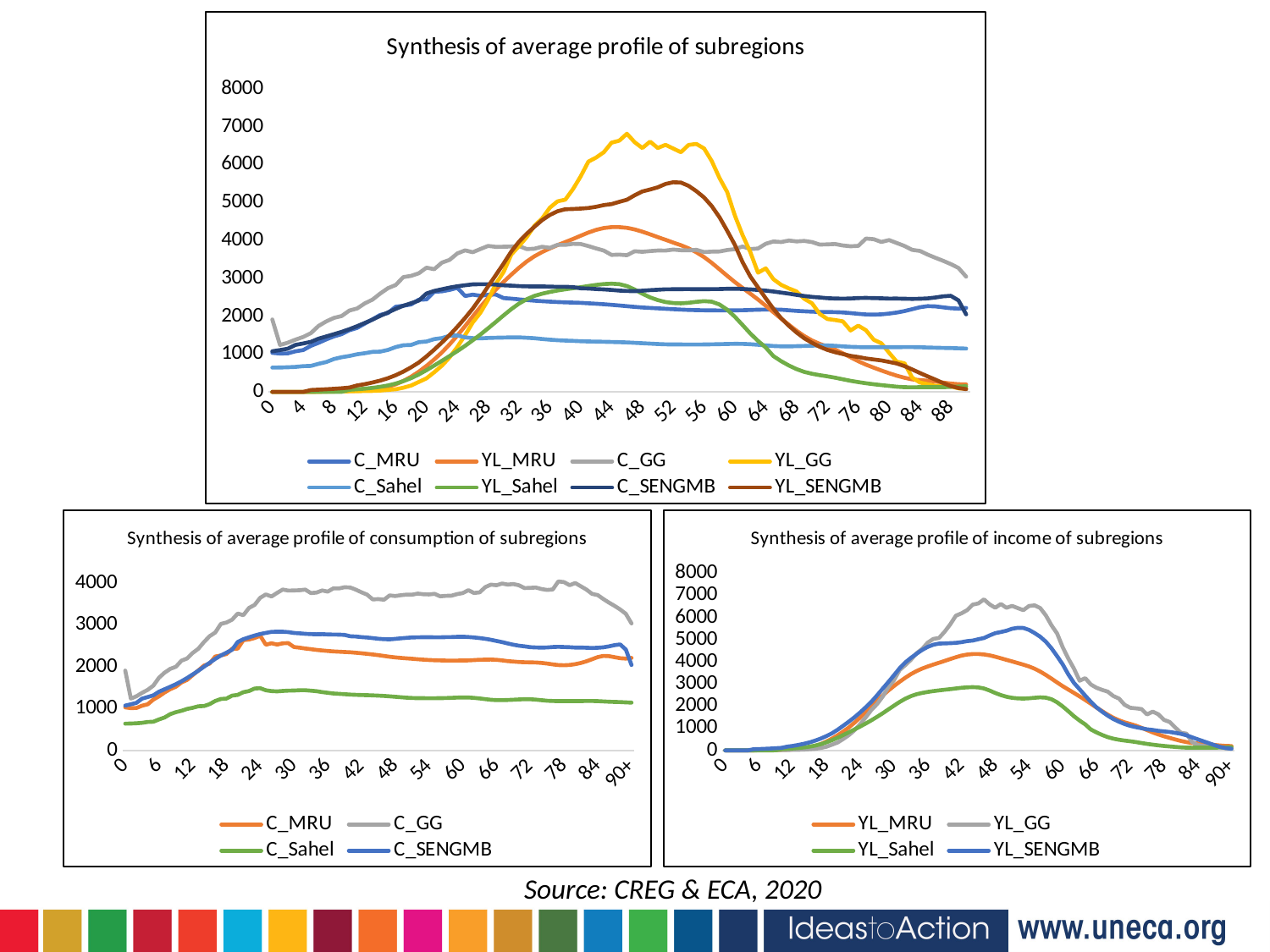
In the bottom-left chart "Synthesis of average profile of consumption of subregions", which series has the lowest values across the age range? C_Sahel In the bottom-right chart "Synthesis of average profile of income of subregions", is the value for YL_SENGMB at age 54 greater or less than 5000? greater In the top chart "Synthesis of average profile of subregions", is the value for C_Sahel at age 40 greater or less than 2000? less In the top chart "Synthesis of average profile of subregions", which series reaches the highest peak value? YL_GG In the bottom-left chart "Synthesis of average profile of consumption of subregions", how many series does the legend list? 4 In the top chart "Synthesis of average profile of subregions", how many series does the legend list? 8 In the bottom-right chart "Synthesis of average profile of income of subregions", do the values for YL_GG rise or fall between age 60 and age 84? fall In the bottom-right chart "Synthesis of average profile of income of subregions", which series reaches the highest peak? YL_GG In the top chart "Synthesis of average profile of subregions", is the value for YL_GG at age 48 greater or less than 6000? greater What kind of chart is the top chart titled "Synthesis of average profile of subregions"? line chart What is the title of the bottom-right chart? Synthesis of average profile of income of subregions